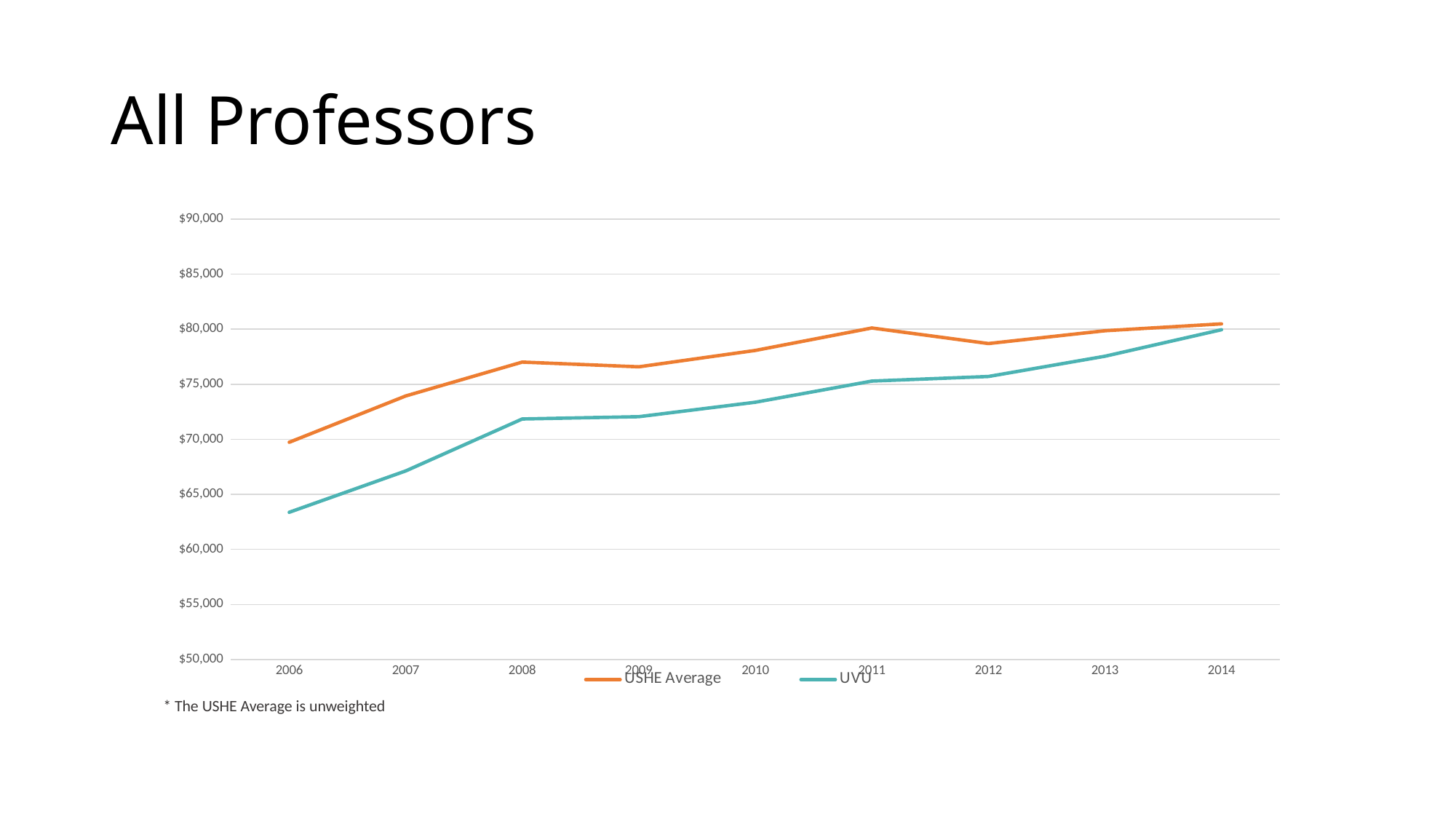
Does the UVU line generally rise or fall from 2006 to 2014? rise In 2006, which series has the larger value, USHE Average or UVU? USHE Average Is the USHE Average value for 2012 greater or less than $80,000? less In which year is the UVU value highest? 2014 What kind of chart is shown on the slide? line chart Is the UVU value for 2010 greater or less than $75,000? less Is the UVU value for 2008 greater or less than $70,000? greater In which year is the UVU value lowest? 2006 How many years are plotted along the x axis? 9 How many series does the legend list? 2